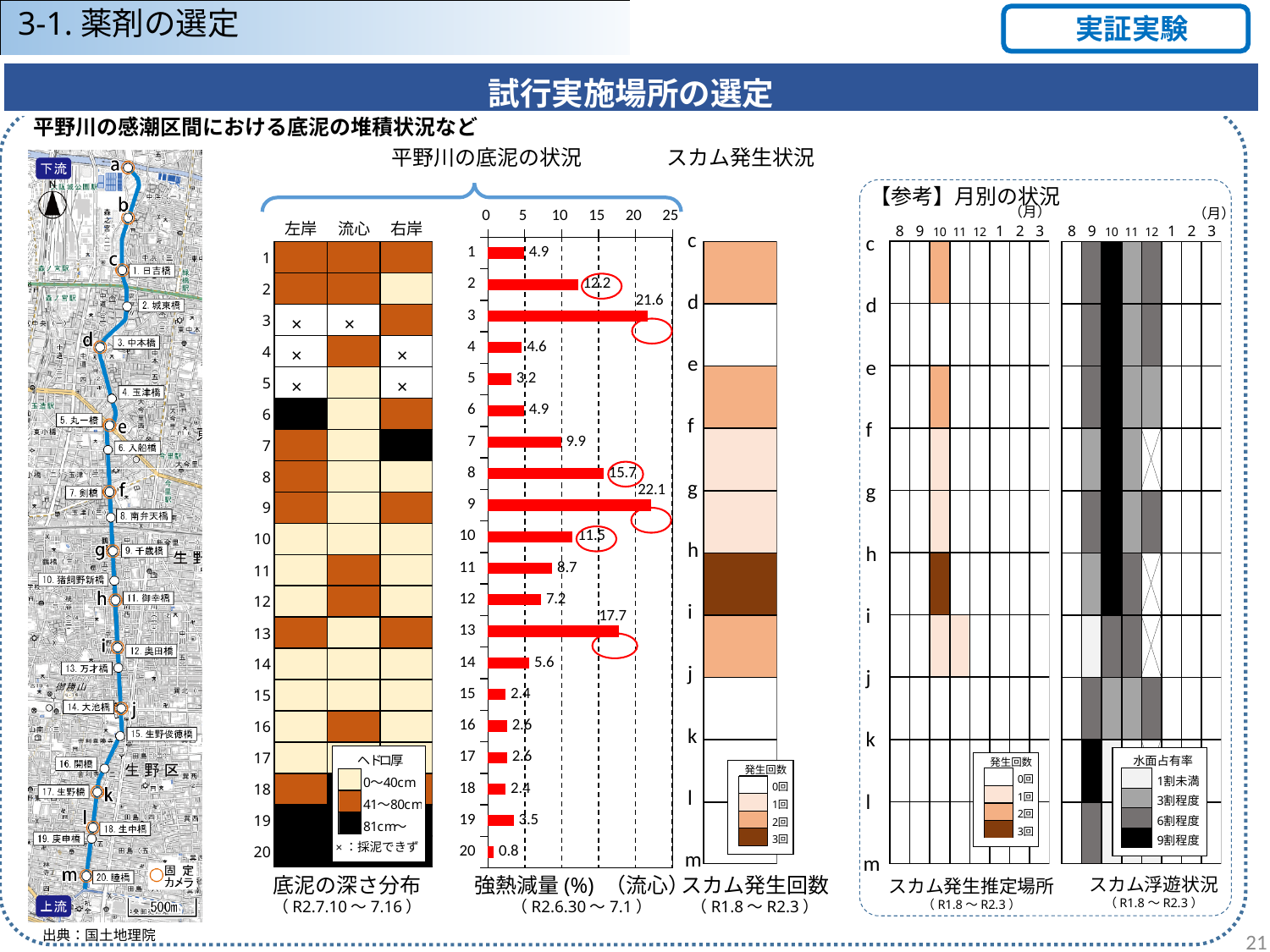
In the 強熱減量 (%) bar chart, which point has the lowest value? 20 In the 強熱減量 (%) bar chart, what is the value for point 13? 17.7 In the 強熱減量 (%) bar chart, what is the value for point 3? 21.6 In the 強熱減量 (%) bar chart, what is the value for point 20? 0.8 In the 強熱減量 (%) bar chart, what is the value for point 9? 22.1 What kind of chart is the 強熱減量 (%) chart? bar chart In the 強熱減量 (%) bar chart, what is the difference between the values for point 9 and point 3? 0.5 In the 強熱減量 (%) bar chart, which is larger, the value for point 8 or the value for point 10? point 8 How many points (bars) are plotted in the 強熱減量 (%) bar chart? 20 In the 強熱減量 (%) bar chart, is the value for point 13 greater or less than 15? greater In the 強熱減量 (%) bar chart, what is the difference between the values for point 8 and point 2? 3.5 In the 強熱減量 (%) bar chart, which point has the highest value? 9